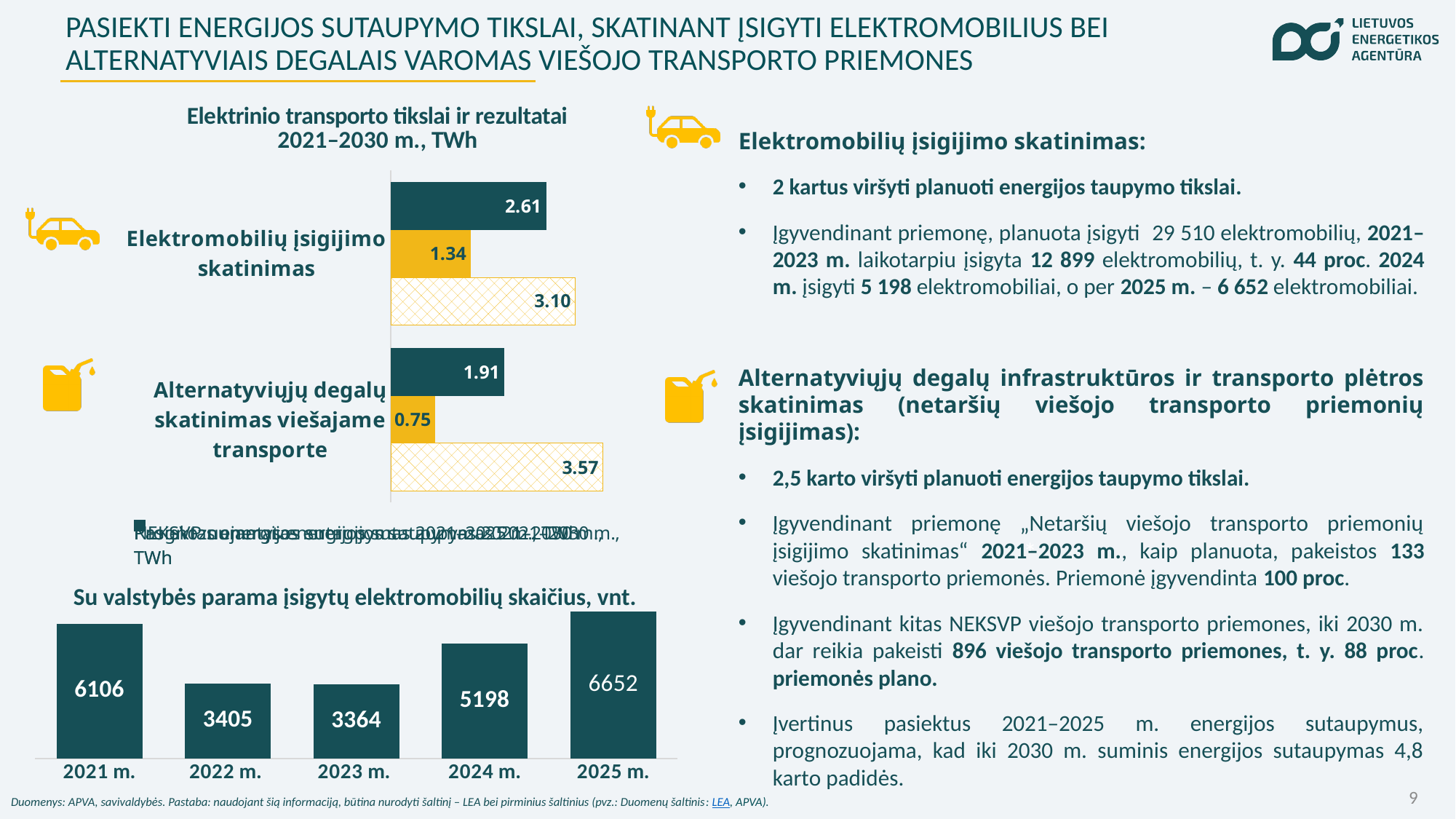
In the chart 'Elektrinio transporto tikslai ir rezultatai 2021–2030 m., TWh', which is larger: the yellow bar for 'Elektromobilių įsigijimo skatinimas' or the yellow bar for 'Alternatyviųjų degalų skatinimas viešajame transporte'? Elektromobilių įsigijimo skatinimas What type of chart is 'Su valstybės parama įsigytų elektromobilių skaičius, vnt.'? bar chart In the chart 'Elektrinio transporto tikslai ir rezultatai 2021–2030 m., TWh', what is the value of the hatched bar for 'Alternatyviųjų degalų skatinimas viešajame transporte'? 3.57 In the chart 'Su valstybės parama įsigytų elektromobilių skaičius, vnt.', how many years are shown? 5 In the chart 'Su valstybės parama įsigytų elektromobilių skaičius, vnt.', what is the value for 2021 m.? 6106 In the chart 'Su valstybės parama įsigytų elektromobilių skaičius, vnt.', which year has the highest value? 2025 m. In the chart 'Elektrinio transporto tikslai ir rezultatai 2021–2030 m., TWh', what is the value of the dark teal bar for 'Elektromobilių įsigijimo skatinimas'? 2.61 In the chart 'Elektrinio transporto tikslai ir rezultatai 2021–2030 m., TWh', what is the value of the yellow bar for 'Alternatyviųjų degalų skatinimas viešajame transporte'? 0.75 In the chart 'Elektrinio transporto tikslai ir rezultatai 2021–2030 m., TWh', how many categories are shown? 2 In the chart 'Su valstybės parama įsigytų elektromobilių skaičius, vnt.', what is the difference between the values for 2025 m. and 2024 m.? 1454 In the chart 'Su valstybės parama įsigytų elektromobilių skaičius, vnt.', what is the value for 2024 m.? 5198 In the chart 'Su valstybės parama įsigytų elektromobilių skaičius, vnt.', which year has the lowest value? 2023 m.